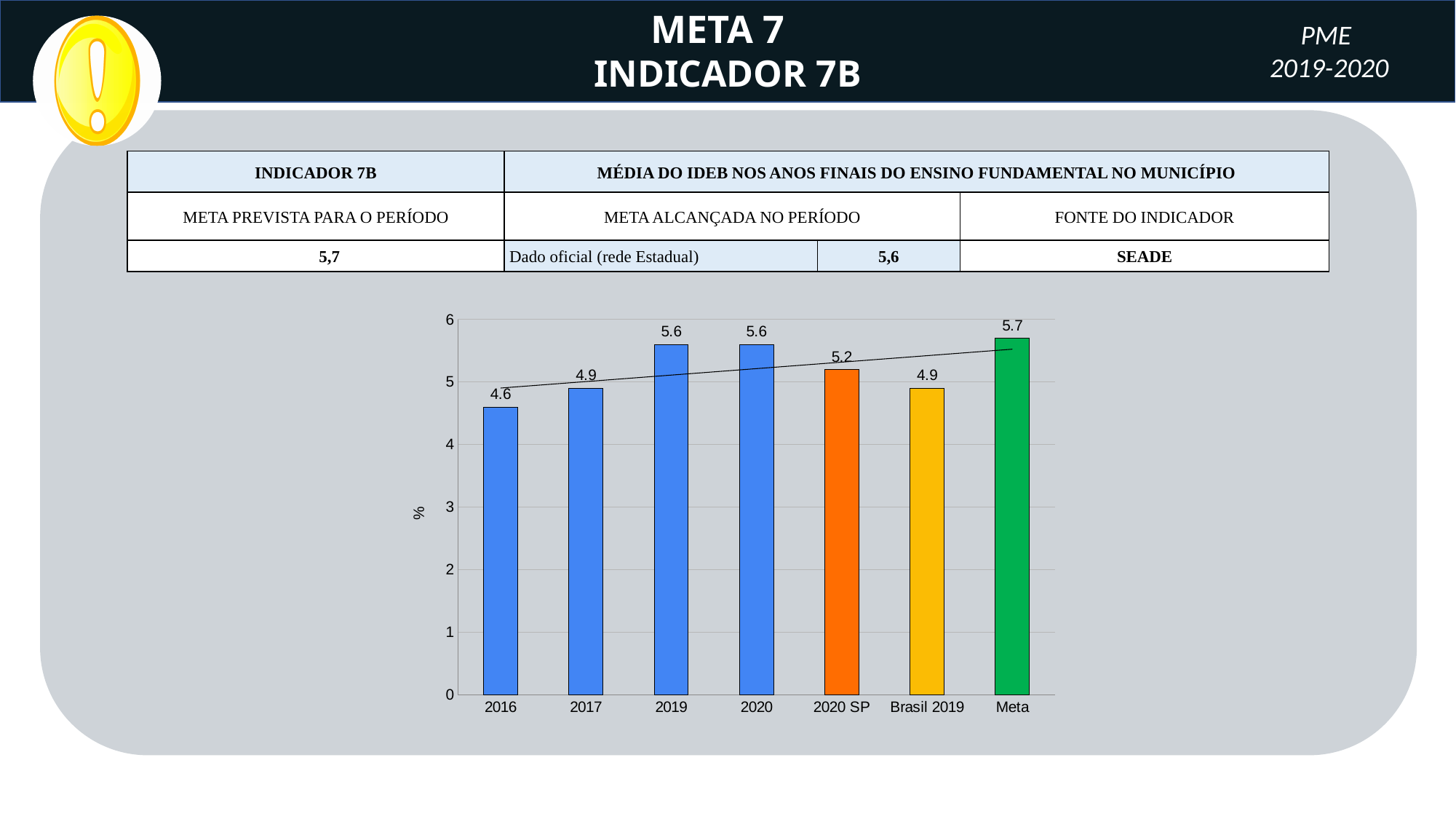
Which category has the highest value in the chart? Meta What is the difference between the 2019 value and the 2016 value? 1.0 Which is larger, the value for 2020 or the value for 2020 SP? 2020 What is the value for Meta in the chart? 5.7 Do the values rise or fall from 2016 to 2019? rise What is the value for 2020 SP in the chart? 5.2 What is the value for Brasil 2019 in the chart? 4.9 Which category has the lowest value in the chart? 2016 What kind of chart is shown on the slide? bar chart How many bars are shown in the chart? 7 What is the difference between the Meta value and the 2020 value? 0.1 What is the value for 2016 in the chart? 4.6